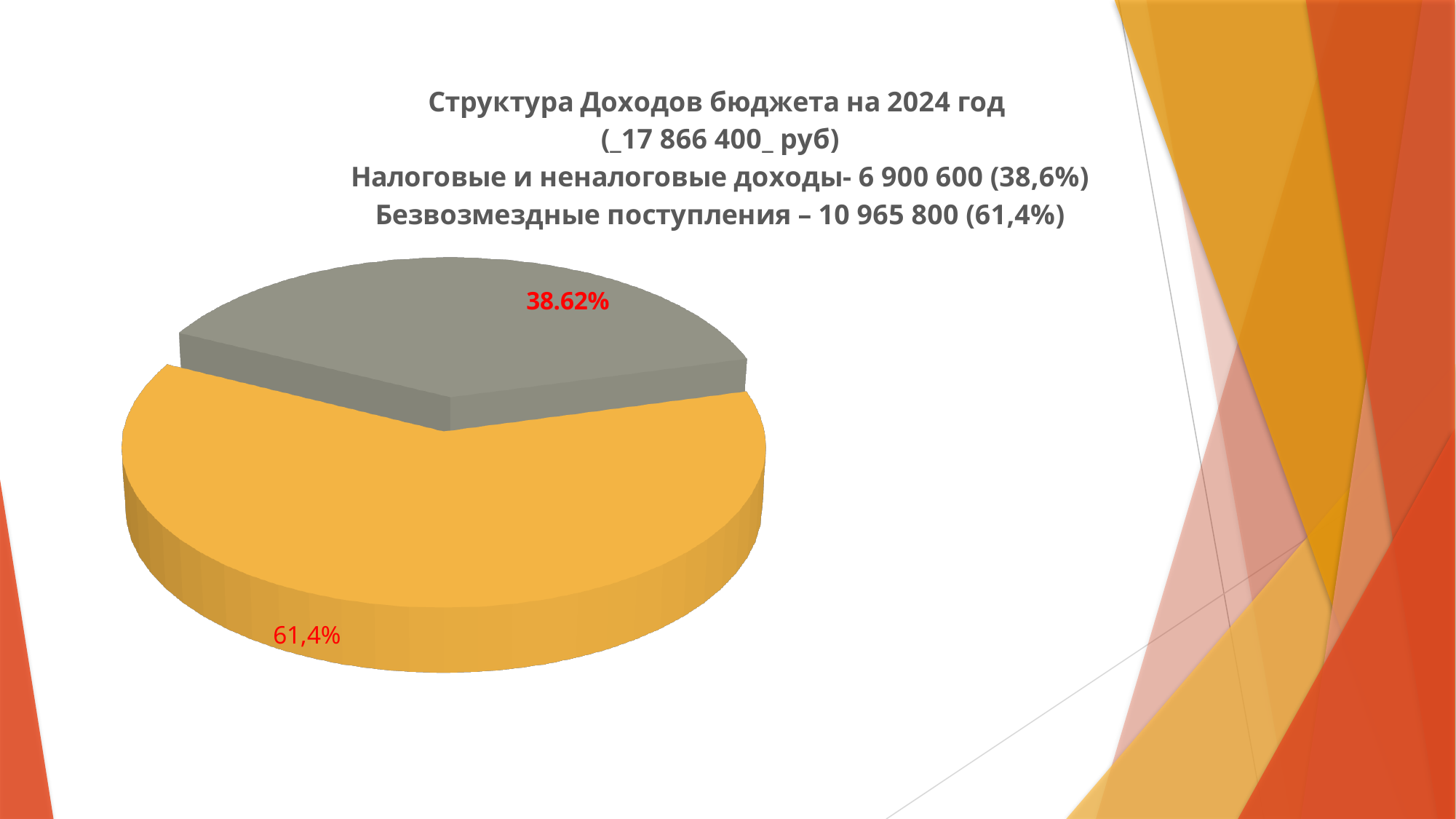
What percentage label is shown on the orange slice of the pie chart? 61,4% What total budget revenue amount is given in the chart title? 17 866 400 руб What colour is the slice labelled 38.62%? gray How many slices does the pie chart have? 2 What kind of chart is shown on the slide? pie chart According to the slide text, what is the amount for Налоговые и неналоговые доходы? 6 900 600 (38,6%) What percentage label is shown on the gray slice of the pie chart? 38.62% Which slice of the pie chart is the largest? the orange slice (61,4%) What year does the chart title refer to? 2024 Which slice of the pie chart is the smallest? the gray slice (38.62%) Which is larger in the pie chart: the gray slice or the orange slice? the orange slice According to the slide text, what is the amount for Безвозмездные поступления? 10 965 800 (61,4%)